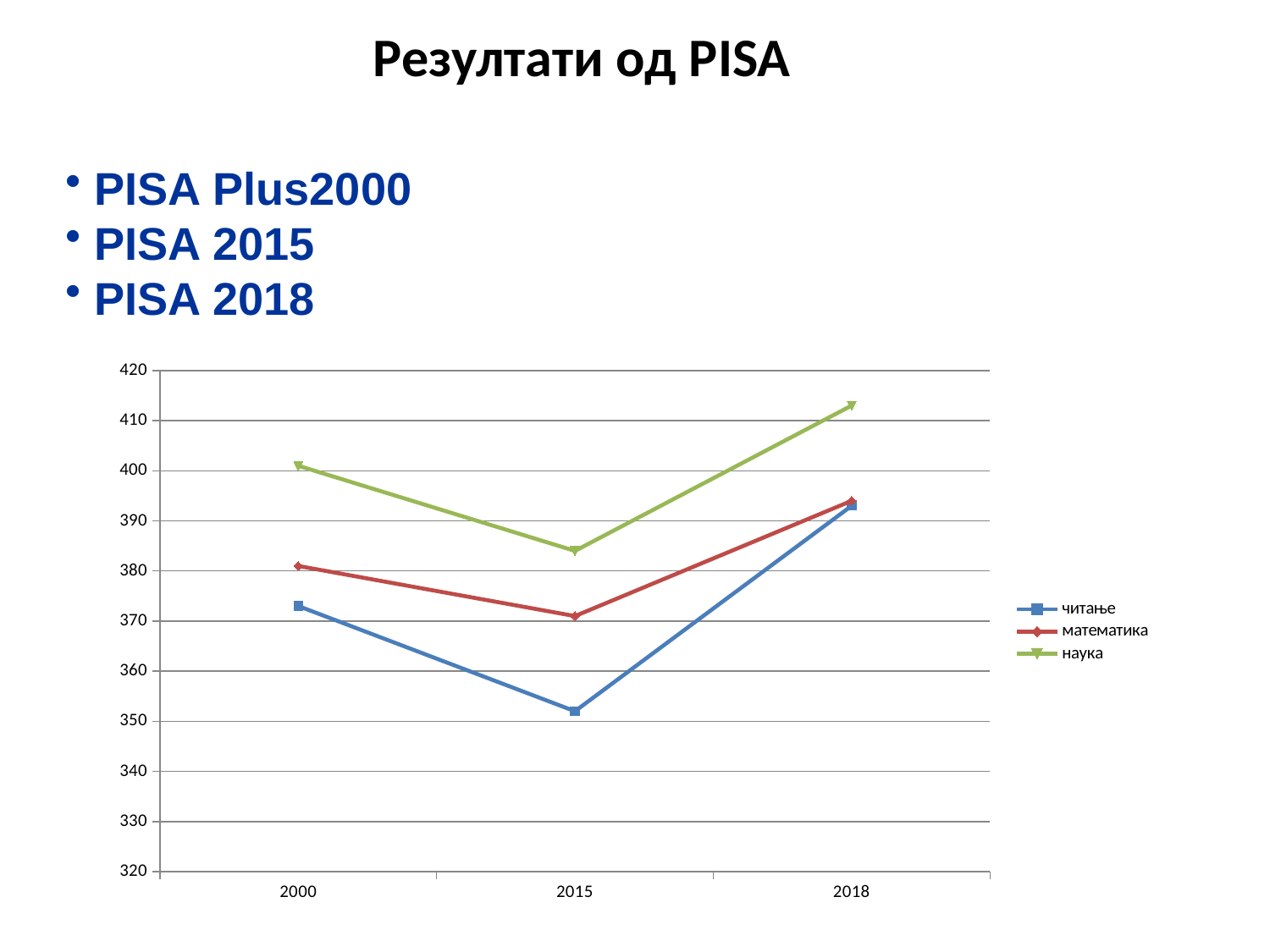
Which series has the lowest value in 2015? читање Does the value for математика rise or fall from 2015 to 2018? rise Which series has the highest value in 2018? наука Which is larger, the value for наука in 2000 or the value for математика in 2000? наука in 2000 In which year is the value for наука highest? 2018 Is the value for читање in 2015 greater or less than 360? less In which year is the value for читање lowest? 2015 How many years are shown on the x axis? 3 Is the value for наука in 2018 greater or less than 410? greater What kind of chart is shown on the slide? line chart How many series does the legend list? 3 Is the value for математика in 2000 greater or less than 390? less